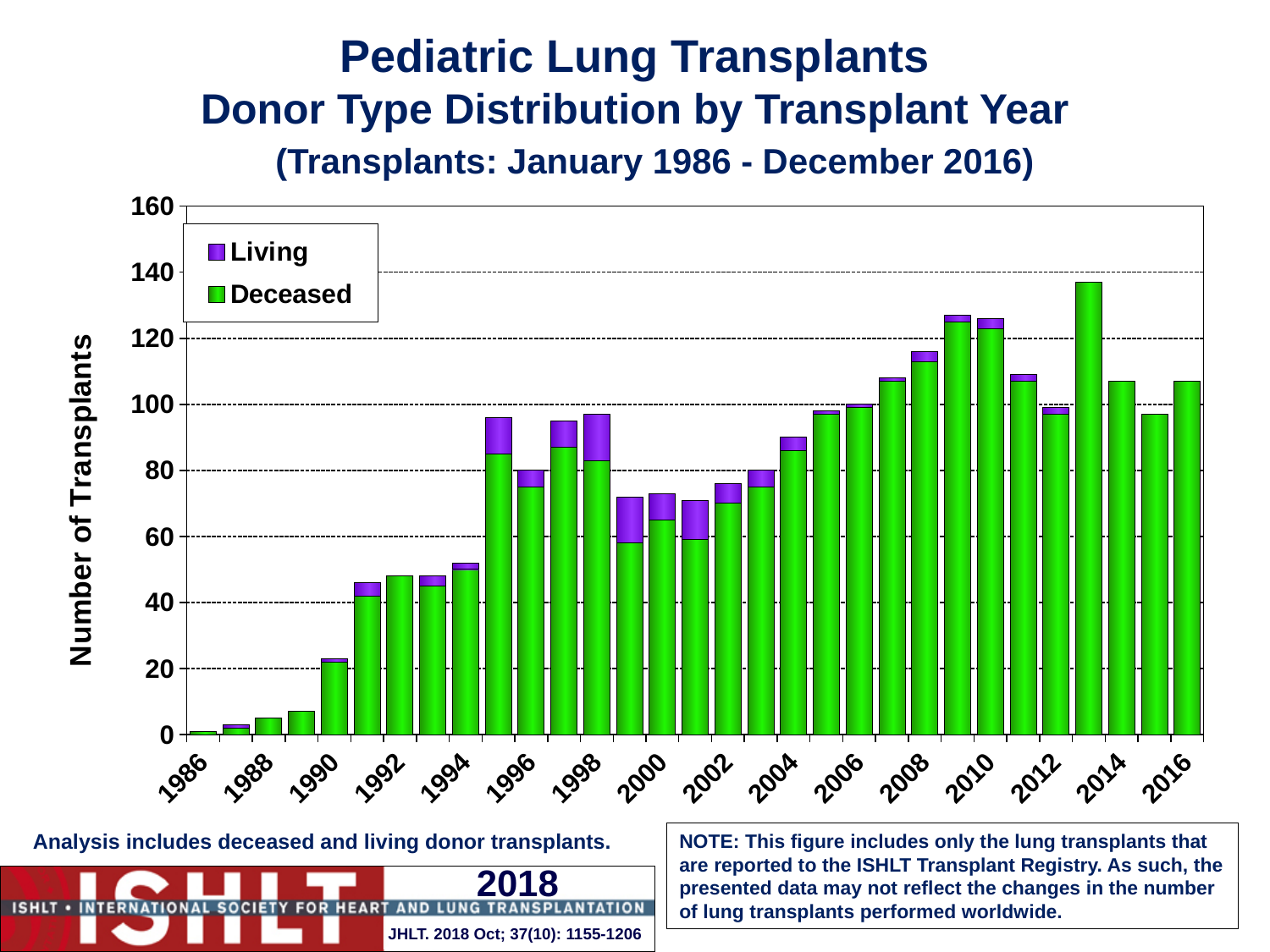
What are the two series named in the legend? Living and Deceased Which transplant year has the highest total number of transplants? 2013 Do the total number of transplants generally rise or fall from 1986 to 1995? rise Is the total number of transplants for 2013 greater or less than 120? greater Is the total number of transplants for 1990 greater or less than 40? less How many transplant years (bars) are plotted in the chart? 31 Is the total number of transplants for 2016 greater or less than 100? greater Which year has more total transplants, 1995 or 1996? 1995 Which transplant year has the lowest total number of transplants? 1986 What kind of chart is shown on the slide? stacked bar chart How many series does the legend list? 2 Which year has more total transplants, 2014 or 2015? 2014